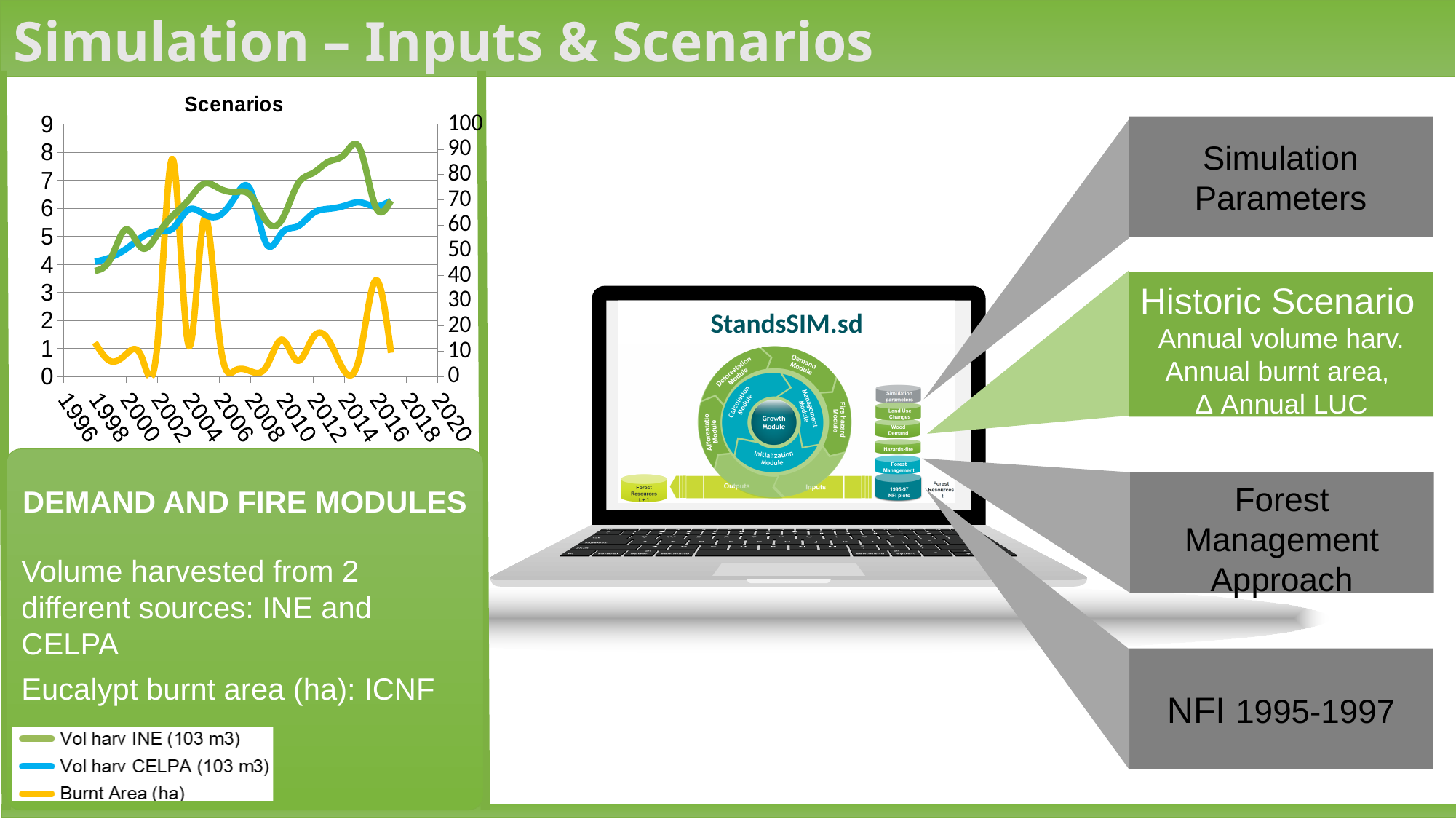
In the 'Scenarios' chart, around 2003, is the 'Burnt Area (ha)' line plotted higher or lower than the 'Vol harv CELPA (103 m3)' line? higher In the 'Scenarios' chart, which series is plotted lowest for most of the years shown? Burnt Area (ha) In the 'Scenarios' chart, does the 'Vol harv INE (103 m3)' line generally rise or fall between 1997 and 2014? rise What kind of chart is the 'Scenarios' chart? line chart How many series does the legend of the 'Scenarios' chart list? 3 In the 'Scenarios' chart, which series reaches the highest point on the plot? Vol harv INE (103 m3) In the 'Scenarios' chart, what colour is the 'Burnt Area (ha)' line? yellow What is the title of the chart on the left of the slide? Scenarios How many year labels are shown on the x axis of the 'Scenarios' chart? 13 In the 'Scenarios' chart, is the peak of the 'Vol harv INE (103 m3)' line plotted above or below the 7 gridline of the left axis? above